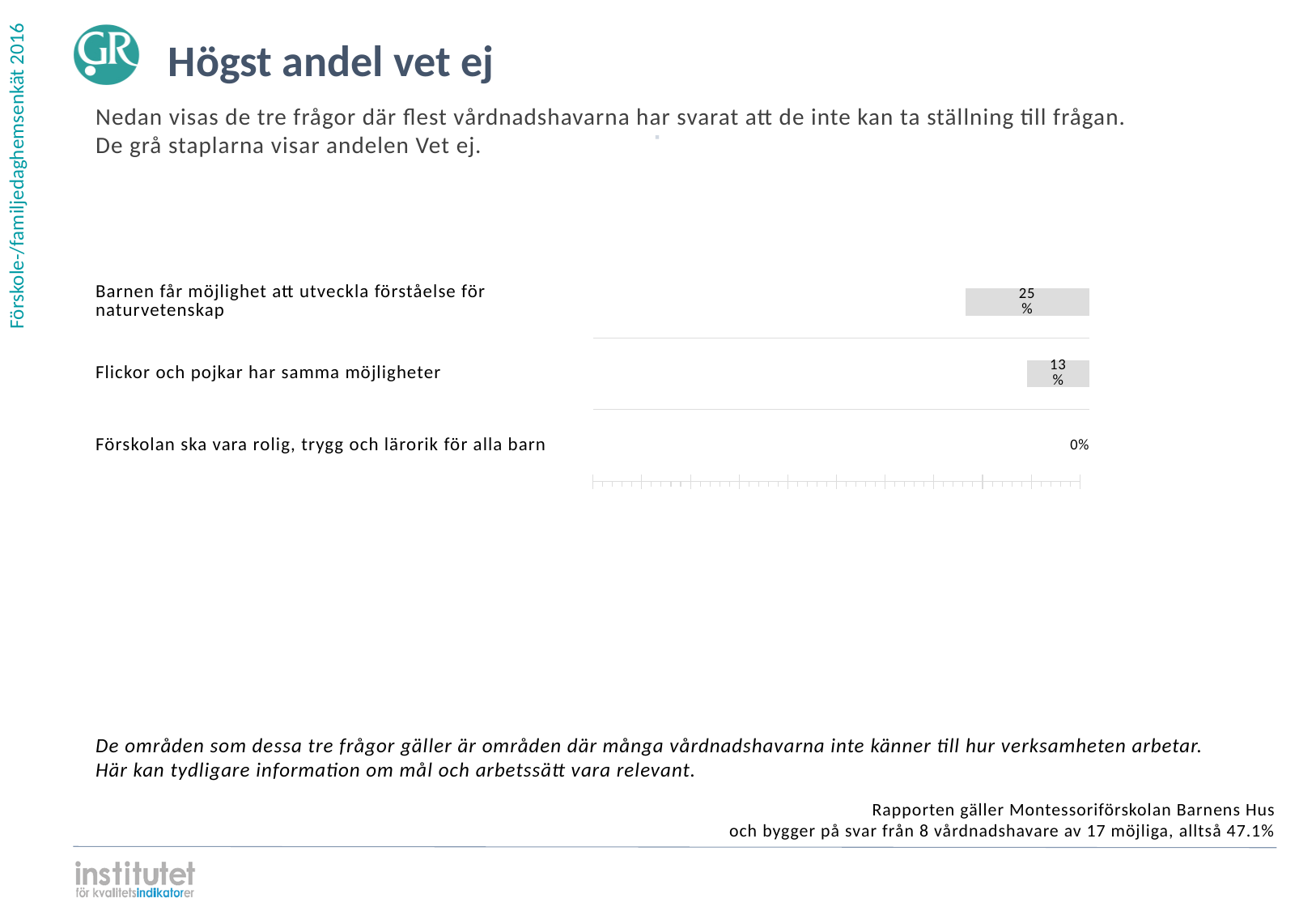
What is the Vet ej share for "Förskolan ska vara rolig, trygg och lärorik för alla barn"? 0% What kind of chart is shown on the slide? Bar chart What is the title of the slide containing the chart? Högst andel vet ej What colour are the bars in the chart? Grey Which question has the highest Vet ej share? Barnen får möjlighet att utveckla förståelse för naturvetenskap Which question has the lowest Vet ej share? Förskolan ska vara rolig, trygg och lärorik för alla barn What is the Vet ej share for "Flickor och pojkar har samma möjligheter"? 13% What is the difference in Vet ej share between "Barnen får möjlighet att utveckla förståelse för naturvetenskap" and "Flickor och pojkar har samma möjligheter"? 12 percentage points How many questions (categories) are shown in the chart? 3 Which has a larger Vet ej share: "Flickor och pojkar har samma möjligheter" or "Förskolan ska vara rolig, trygg och lärorik för alla barn"? Flickor och pojkar har samma möjligheter What is the Vet ej share for "Barnen får möjlighet att utveckla förståelse för naturvetenskap"? 25%